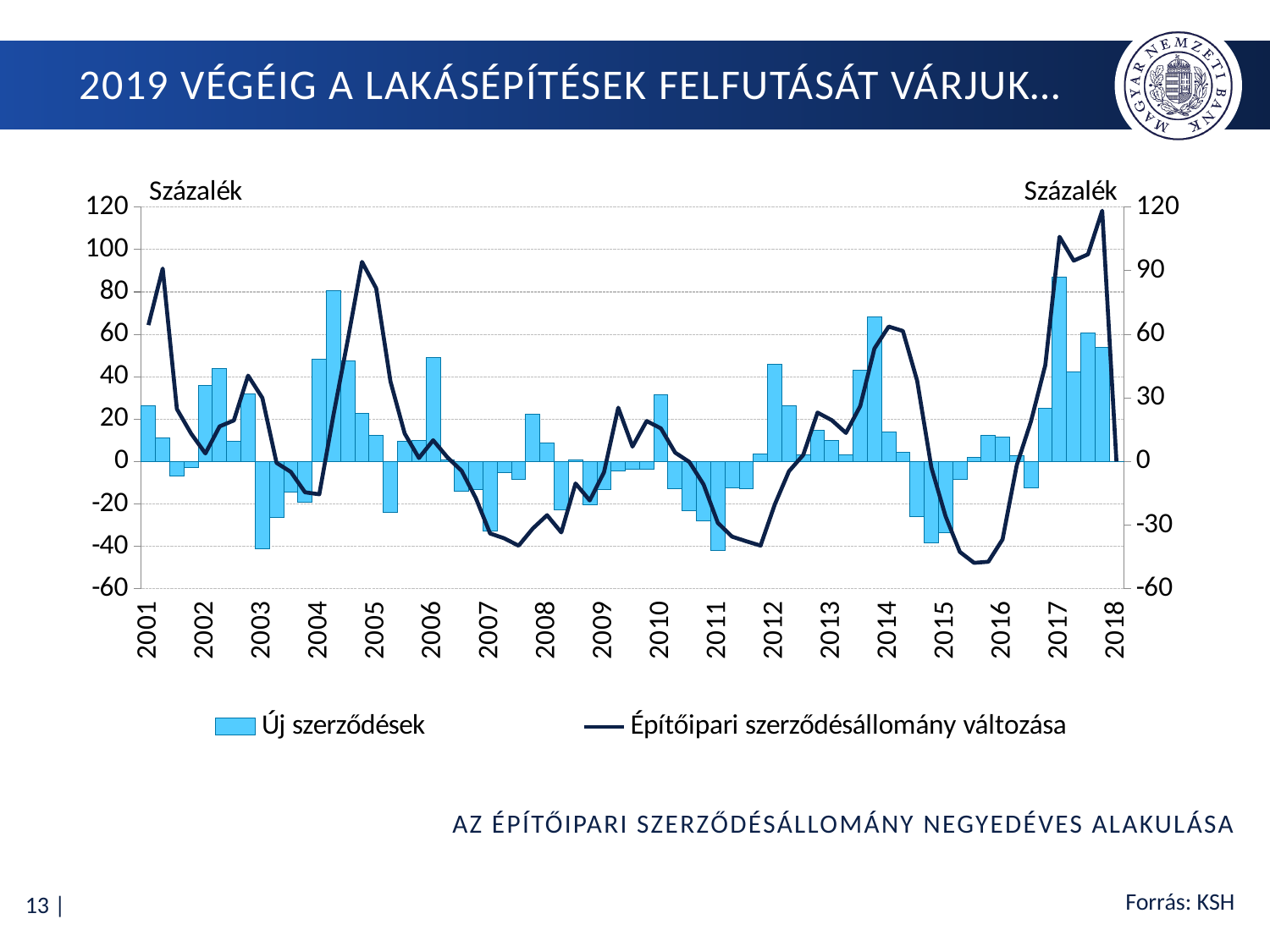
Does the Építőipari szerződésállomány változása line rise or fall from 2016 to 2017? rise What kind of chart is shown on the slide? Combined bar and line chart Is the lowest Új szerződések bar, in 2003, greater or less than -20 on the left axis? less Is the peak of the Építőipari szerződésállomány változása line in 2018 greater or less than 90 on the right axis? greater How many series does the legend list? 2 Is the lowest point of the Építőipari szerződésállomány változása line, around 2015–2016, greater or less than -30 on the right axis? less What is the title of the chart shown below the plot? Az építőipari szerződésállomány negyedéves alakulása Which series is plotted as bars? Új szerződések How many years are labelled on the x axis? 18 What source is cited for the chart? KSH